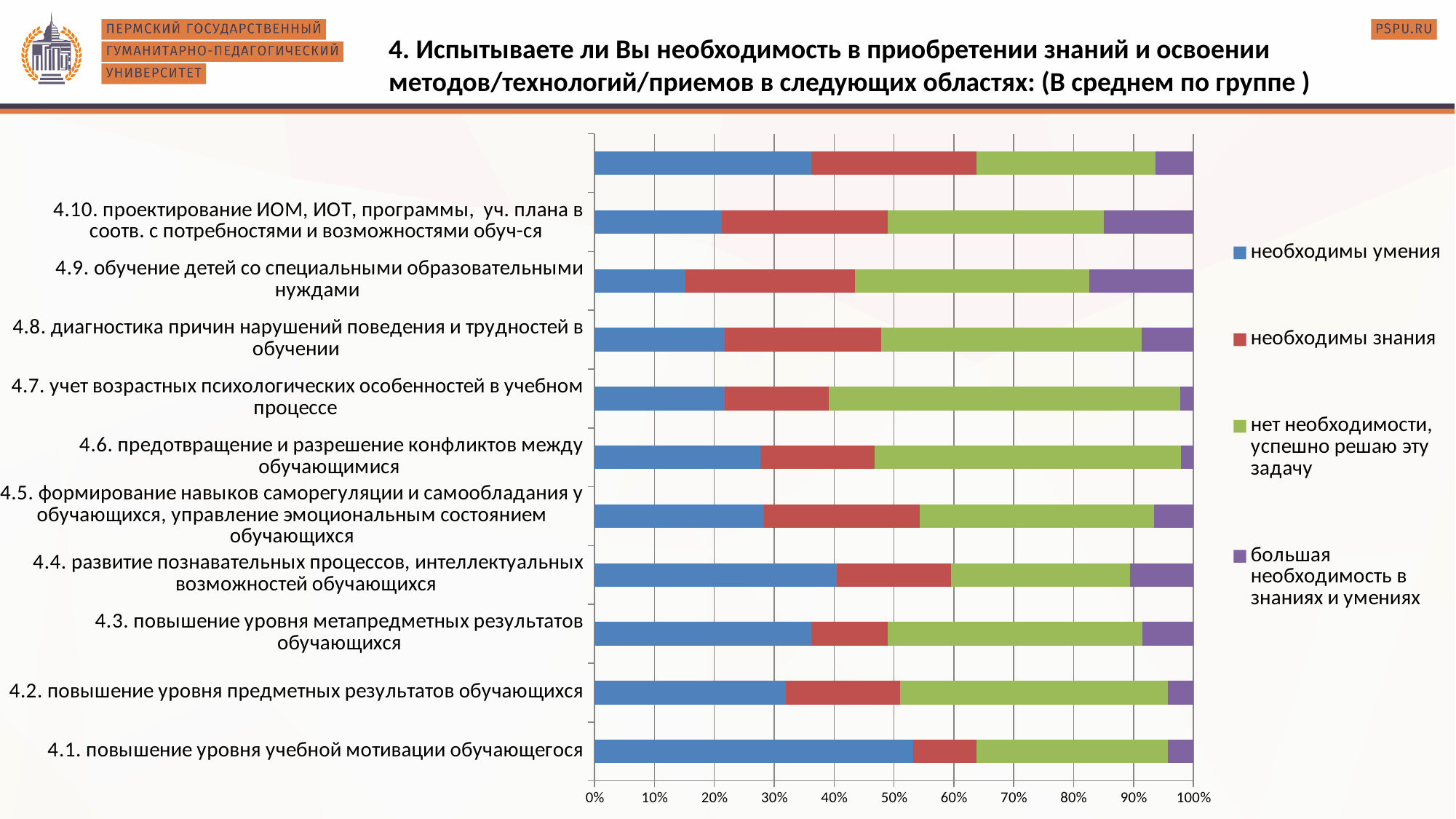
Is the 'необходимы умения' value for 4.9 greater or less than 20%? less Which category has the smallest 'необходимы умения' (blue) segment? 4.9. обучение детей со специальными образовательными нуждами Which category has the largest 'нет необходимости, успешно решаю эту задачу' (green) segment? 4.7. учет возрастных психологических особенностей в учебном процессе What kind of chart is shown on the slide? stacked bar chart Which has a larger 'необходимы умения' (blue) segment: 4.4 or 4.2? 4.4 What colour represents 'необходимы знания' in the legend? red How many stacked bars are plotted in the chart? 11 Is the 'необходимы умения' value for 4.3 greater or less than 30%? greater What is the total of each stacked bar, as shown by the x axis? 100% Is the 'необходимы умения' value for 4.1 greater or less than 50%? greater How many series does the legend list? 4 Which category has the largest 'необходимы умения' (blue) segment? 4.1. повышение уровня учебной мотивации обучающегося